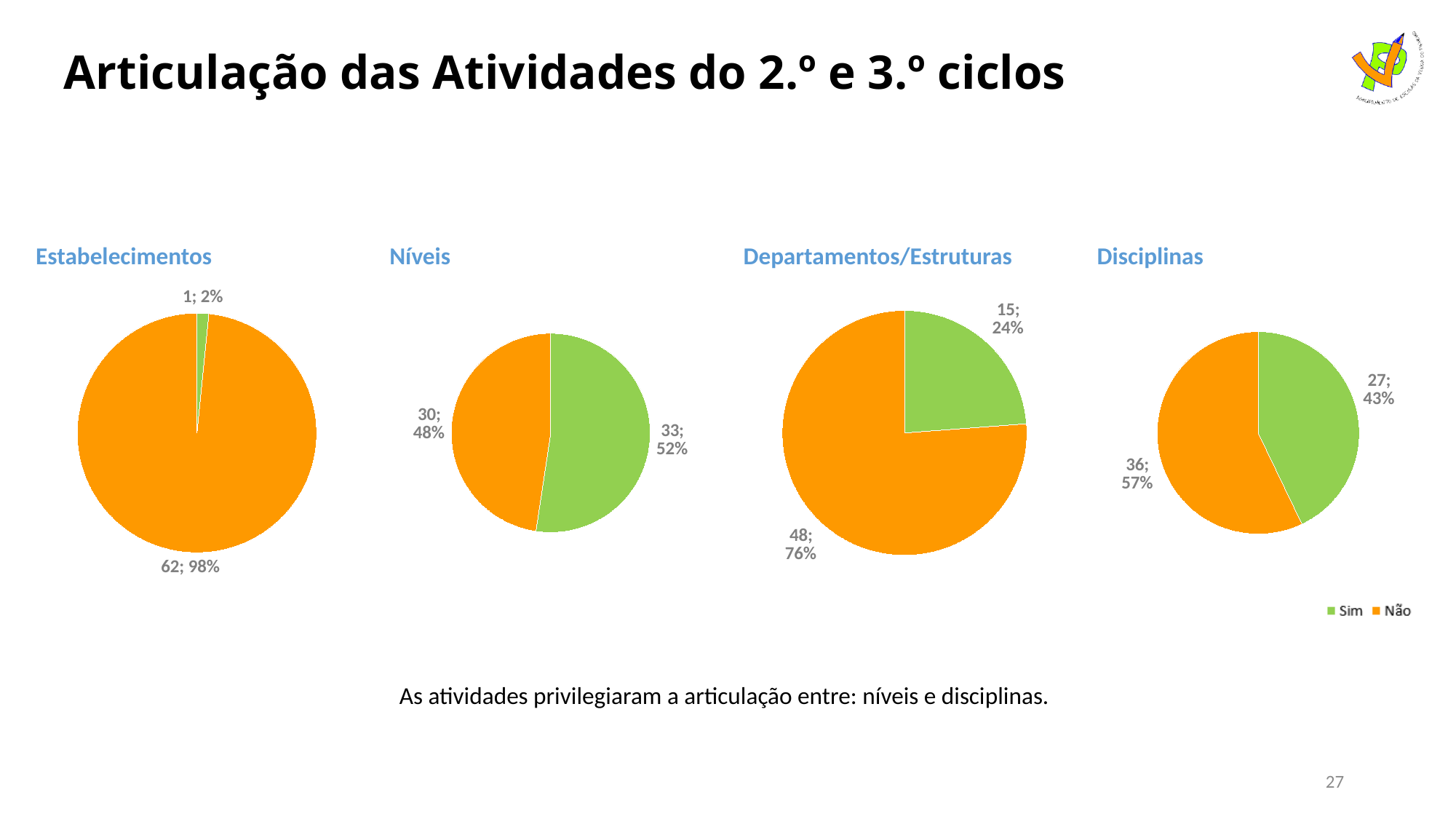
In the Disciplinas pie chart, what is the total count across both slices? 63 Which colour represents Sim in the legend? Green In the Níveis pie chart, what is the difference in count between the Sim and Não slices? 3 What kind of chart is used for Níveis? Pie chart How many series does the legend list? 2 In the Disciplinas pie chart, which slice is the largest? Não In the Estabelecimentos pie chart, what share of the pie does the Sim slice represent? 2% In the Níveis pie chart, what is the value shown for the Sim slice? 33; 52% In the Departamentos/Estruturas pie chart, what is the value shown for the Não slice? 48; 76% In the Disciplinas pie chart, what share of the pie does the Sim slice represent? 43% In the Departamentos/Estruturas pie chart, which slice is larger, Sim or Não? Não In the Estabelecimentos pie chart, what is the value shown for the Não slice? 62; 98%